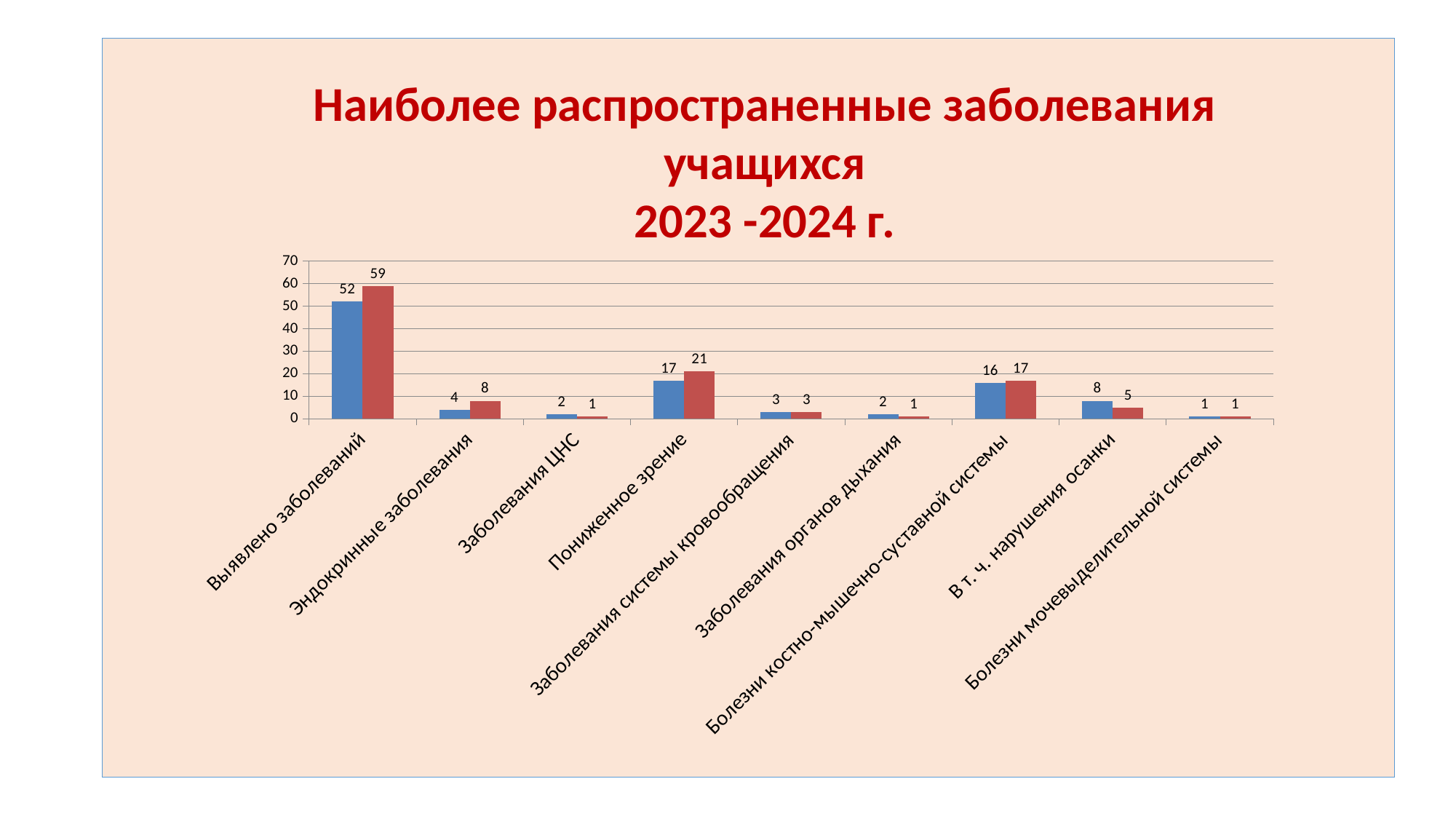
What is the title of the chart? Наиболее распространенные заболевания учащихся 2023 -2024 г. How many categories are shown on the x axis? 9 What is the value of the red bar for "Пониженное зрение"? 21 What is the value of the blue bar for "Выявлено заболеваний"? 52 Which category has the highest red bar? Выявлено заболеваний For "Пониженное зрение", which bar is larger, the blue or the red? red Which category has the lowest blue bar? Болезни мочевыделительной системы What is the difference between the blue and red bars for "В т. ч. нарушения осанки"? 3 What kind of chart is shown on the slide? bar chart Is the value of the red bar for "Выявлено заболеваний" greater or less than 50? greater What is the value of the red bar for "Эндокринные заболевания"? 8 What is the difference between the red and blue bars for "Выявлено заболеваний"? 7